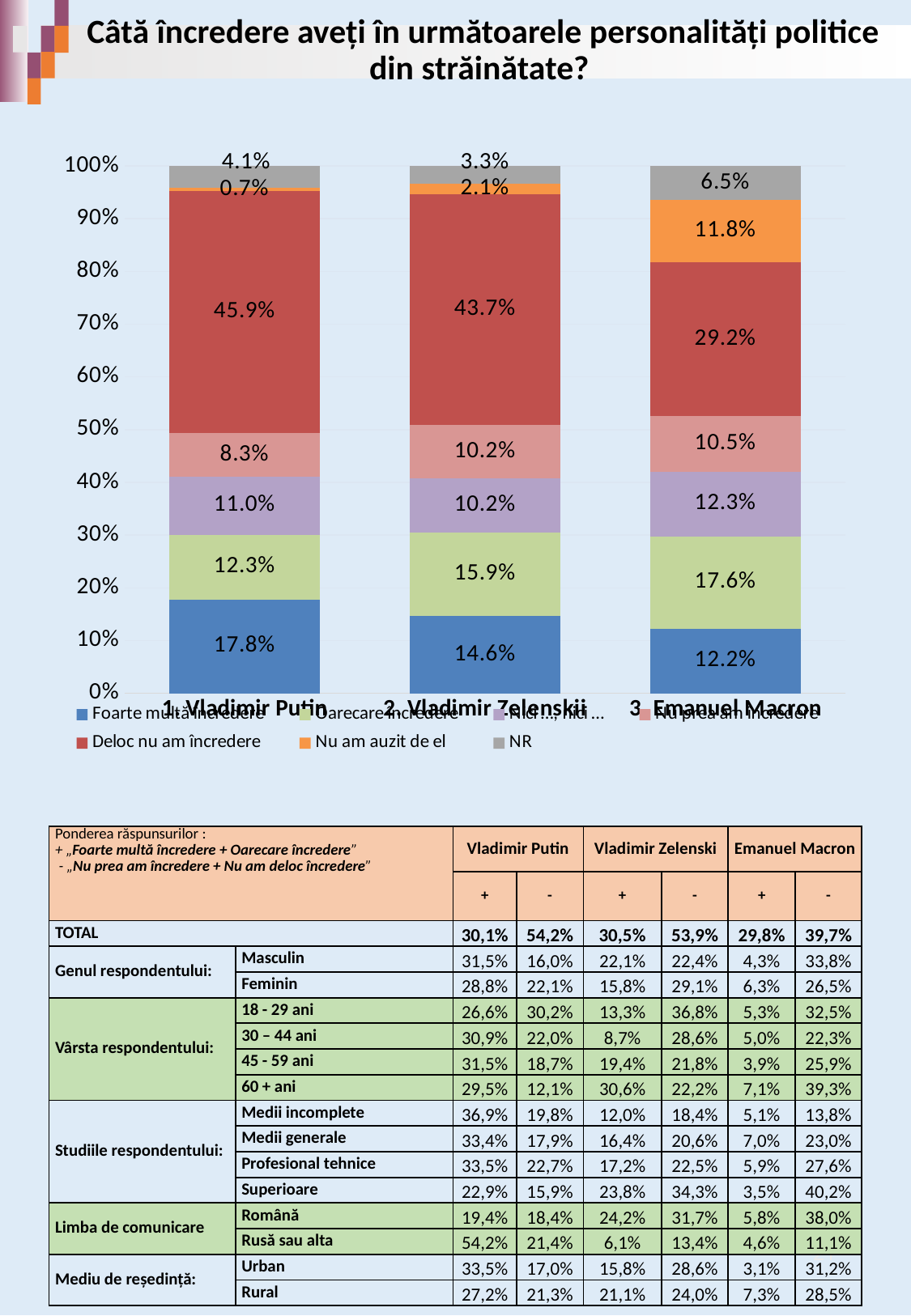
What is the difference between the 'Deloc nu am încredere' values for 1. Vladimir Putin and 3. Emanuel Macron? 16.7% Which is larger: the 'Oarecare încredere' value for 2. Vladimir Zelenskii or for 3. Emanuel Macron? 3. Emanuel Macron What kind of chart is shown on the slide? stacked bar chart How many political personalities (categories) are shown on the x axis of the chart? 3 What is the value of 'Deloc nu am încredere' for 1. Vladimir Putin? 45.9% Which personality has the highest 'Foarte multă încredere' value? 1. Vladimir Putin How many series does the chart legend list? 7 Which personality has the lowest 'Deloc nu am încredere' value? 3. Emanuel Macron What is the value of 'Foarte multă încredere' for 2. Vladimir Zelenskii? 14.6% What is the value of 'Nu am auzit de el' for 3. Emanuel Macron? 11.8% What is the NR value for 2. Vladimir Zelenskii? 3.3% Does the 'Deloc nu am încredere' value decrease from 1. Vladimir Putin to 3. Emanuel Macron along the x axis? yes, it decreases